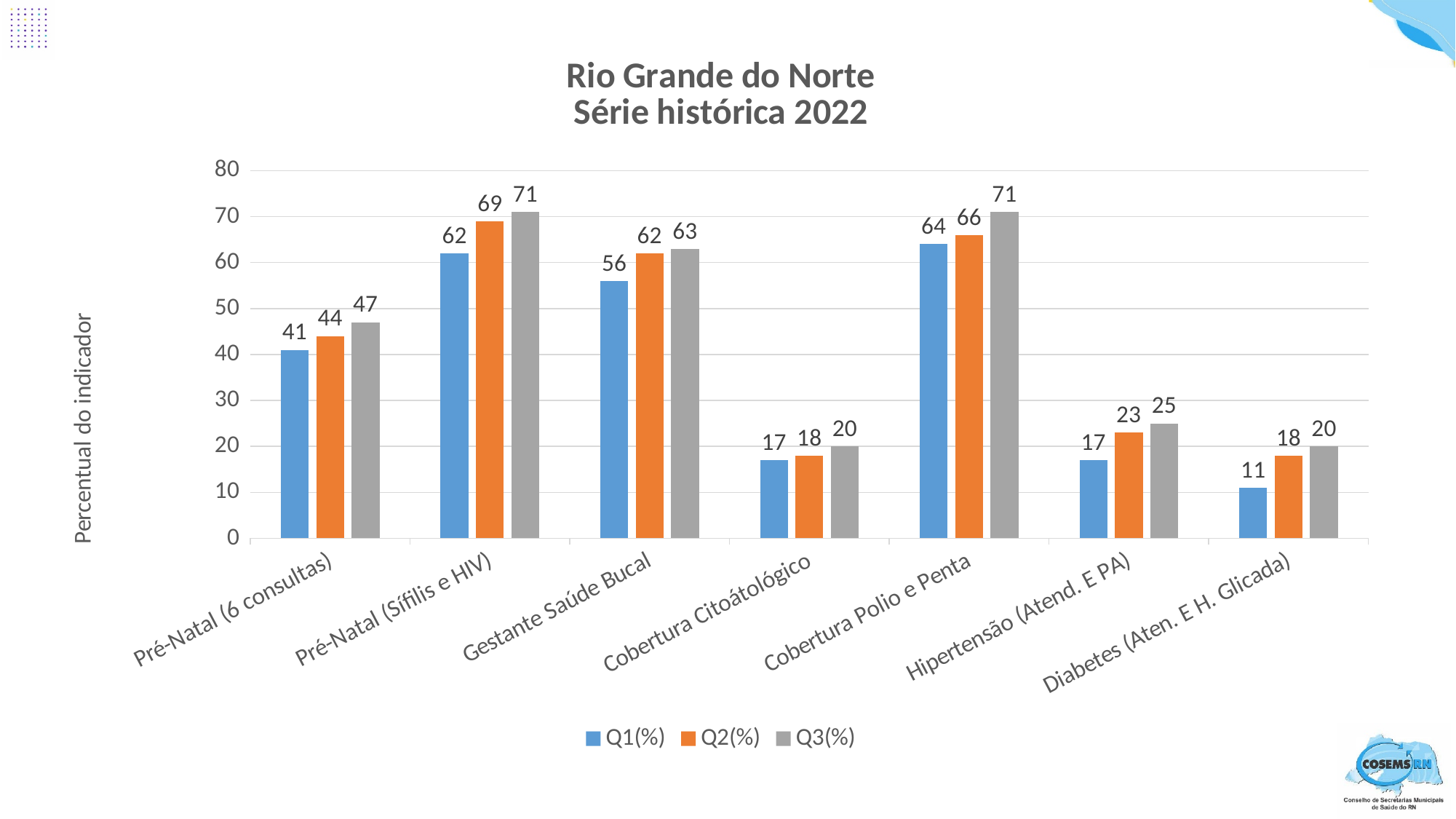
What is the Q3(%) value for Hipertensão (Atend. E PA)? 25 Which is larger: the Q1(%) value for Gestante Saúde Bucal or the Q1(%) value for Cobertura Polio e Penta? Cobertura Polio e Penta Which category has the highest Q2(%) value? Pré-Natal (Sífilis e HIV) What is the title of the chart? Rio Grande do Norte Série histórica 2022 What is the Q2(%) value for Gestante Saúde Bucal? 62 What is the Q1(%) value for Pré-Natal (6 consultas)? 41 Is the Q2(%) value for Cobertura Citoátológico larger than the Q2(%) value for Diabetes (Aten. E H. Glicada)? No, they are equal (18) How many categories are shown on the x axis? 7 How many series does the legend list? 3 What is the difference between the Q3(%) and Q1(%) values for Cobertura Polio e Penta? 7 What kind of chart is shown on the slide? Bar chart Which category has the lowest Q1(%) value? Diabetes (Aten. E H. Glicada)